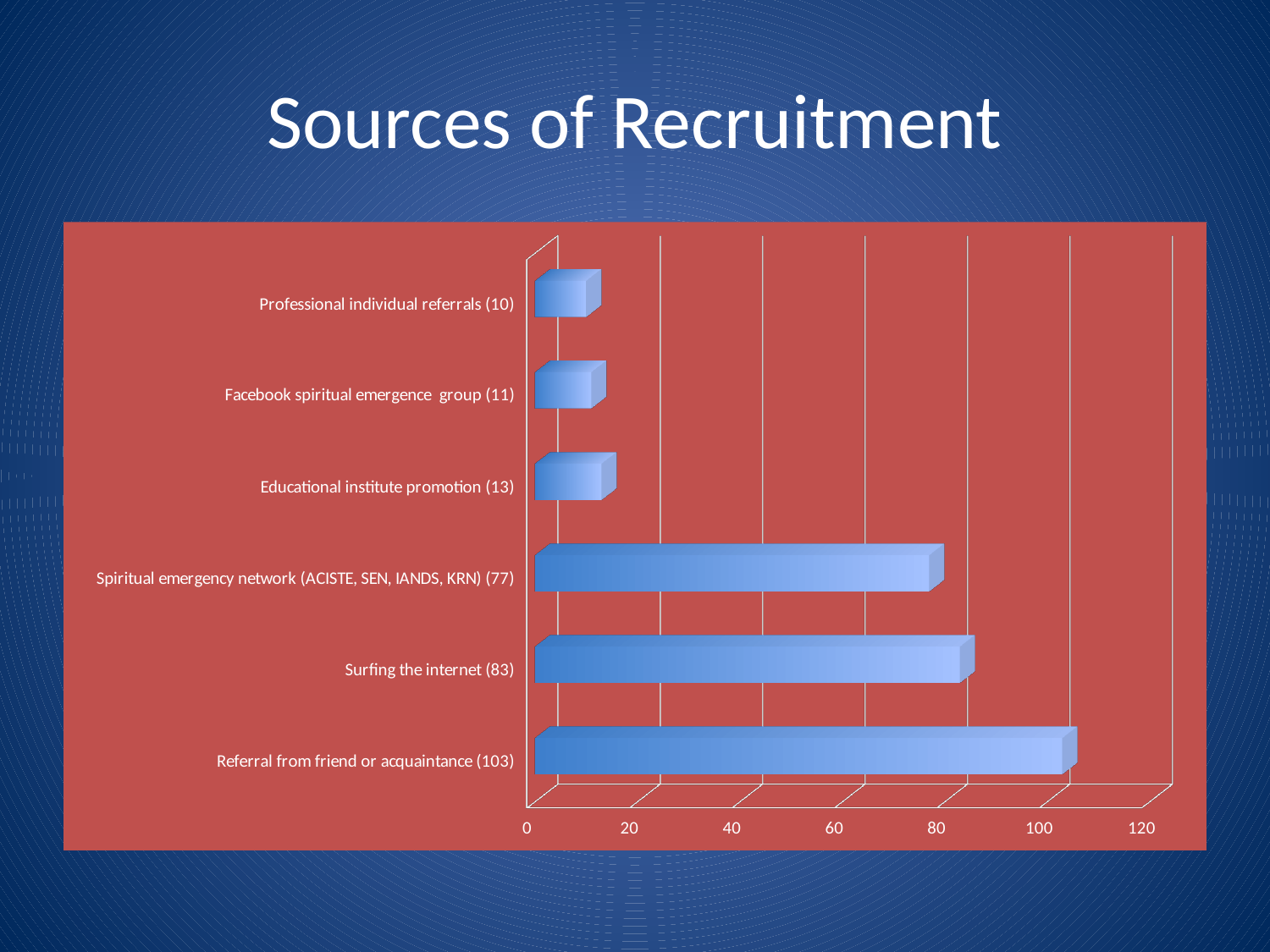
What is the value for Educational institute promotion? 13 What is the value for Surfing the internet? 83 What is the value for Spiritual emergency network (ACISTE, SEN, IANDS, KRN)? 77 Is the value for Spiritual emergency network (ACISTE, SEN, IANDS, KRN) greater or less than 60? greater What is the difference between Referral from friend or acquaintance and Surfing the internet? 20 Which source of recruitment has the highest value? Referral from friend or acquaintance What is the title of the slide? Sources of Recruitment What kind of chart is shown on the slide? bar chart Which source of recruitment has the lowest value? Professional individual referrals Which is larger, Facebook spiritual emergence group or Educational institute promotion? Educational institute promotion How many categories does the chart show? 6 What is the difference between Facebook spiritual emergence group and Professional individual referrals? 1